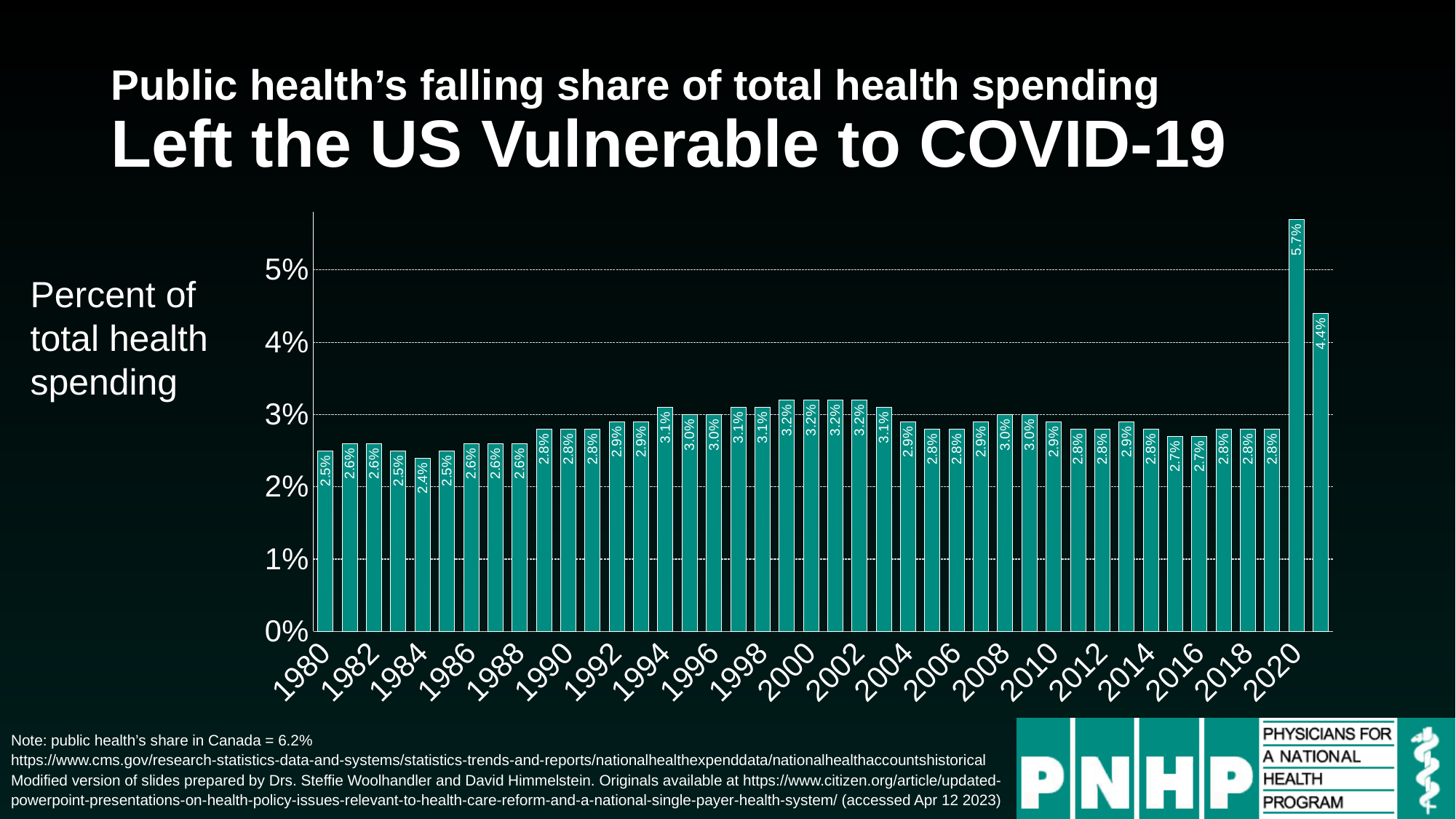
According to the note on the slide, what is public health's share in Canada? 6.2% What is the value for 2000? 3.2% Which is larger, the value for 2020 or the value for 1990? 2020 Which year has the lowest value? 1984 What is the difference between the values for 2020 and 1980? 3.2 percentage points What quantity does the chart's vertical axis represent, according to the label on the slide? Percent of total health spending What kind of chart is shown on the slide? Bar chart Which year has the highest value? 2020 What is the value for 1980? 2.5% What is the value for 2020? 5.7% Is the value for 1984 greater or less than 3%? less Is the value for 2020 greater or less than 5%? greater